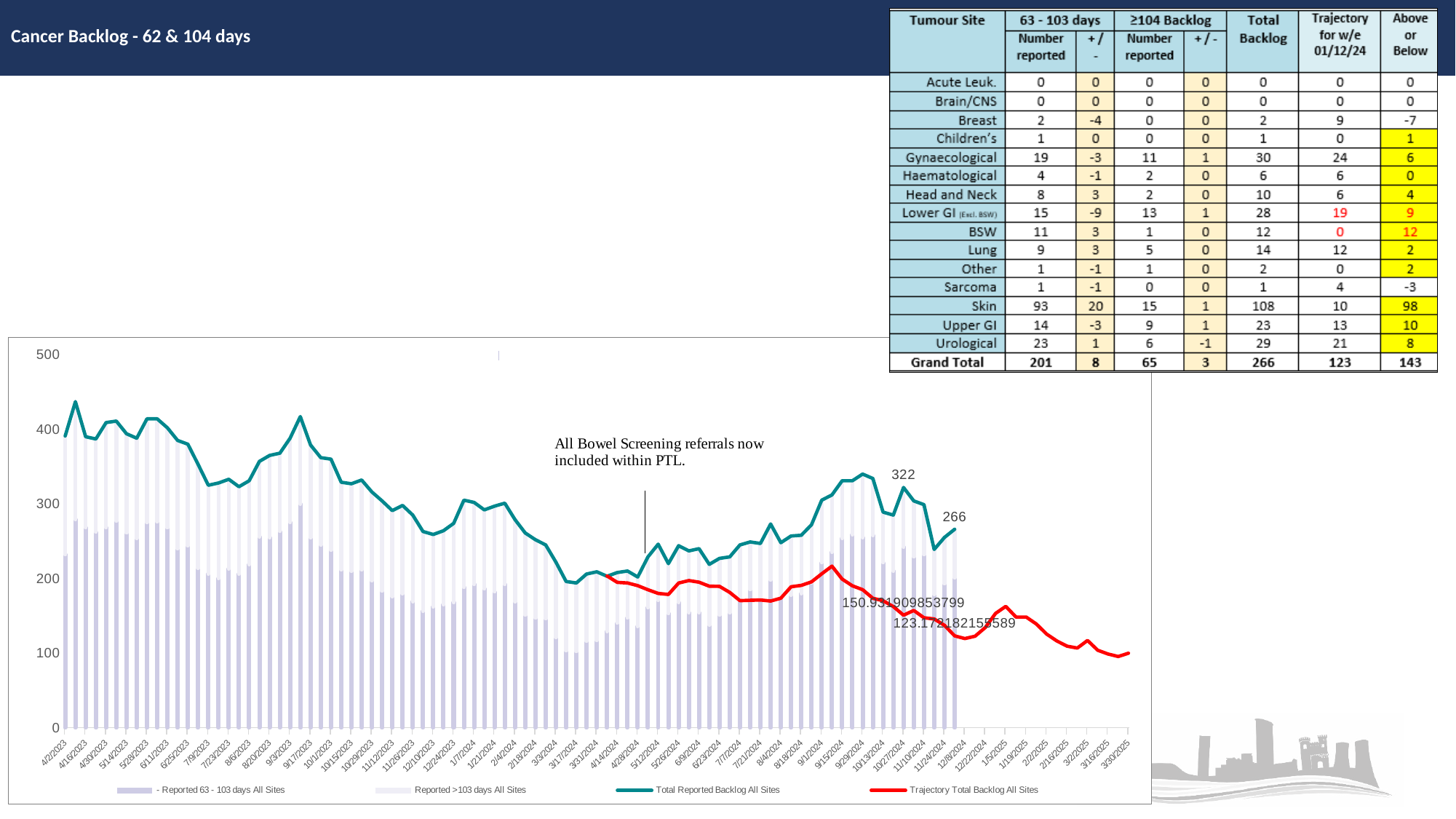
What is the difference between the two labelled Total Reported Backlog values, 322 and 266? 56 What kind of chart is shown on the slide? Combined bar and line chart What is the labelled peak value of the Total Reported Backlog All Sites line near 11/10/2024? 322 Is the Total Reported Backlog All Sites value at 4/2/2023 greater or less than 300? greater How many series does the chart legend list? 4 What does the annotation text on the chart say? All Bowel Screening referrals now included within PTL. What is the last labelled value of the Total Reported Backlog All Sites line? 266 Which of the two labelled Total Reported Backlog values is larger, 322 or 266? 322 Does the Trajectory Total Backlog All Sites line rise or fall between 9/15/2024 and 3/30/2025? fall Is the final labelled Total Reported Backlog value greater or less than 300? less What colour is the Trajectory Total Backlog All Sites line in the chart? Red Is the Trajectory Total Backlog All Sites value at 3/30/2025 greater or less than 200? less